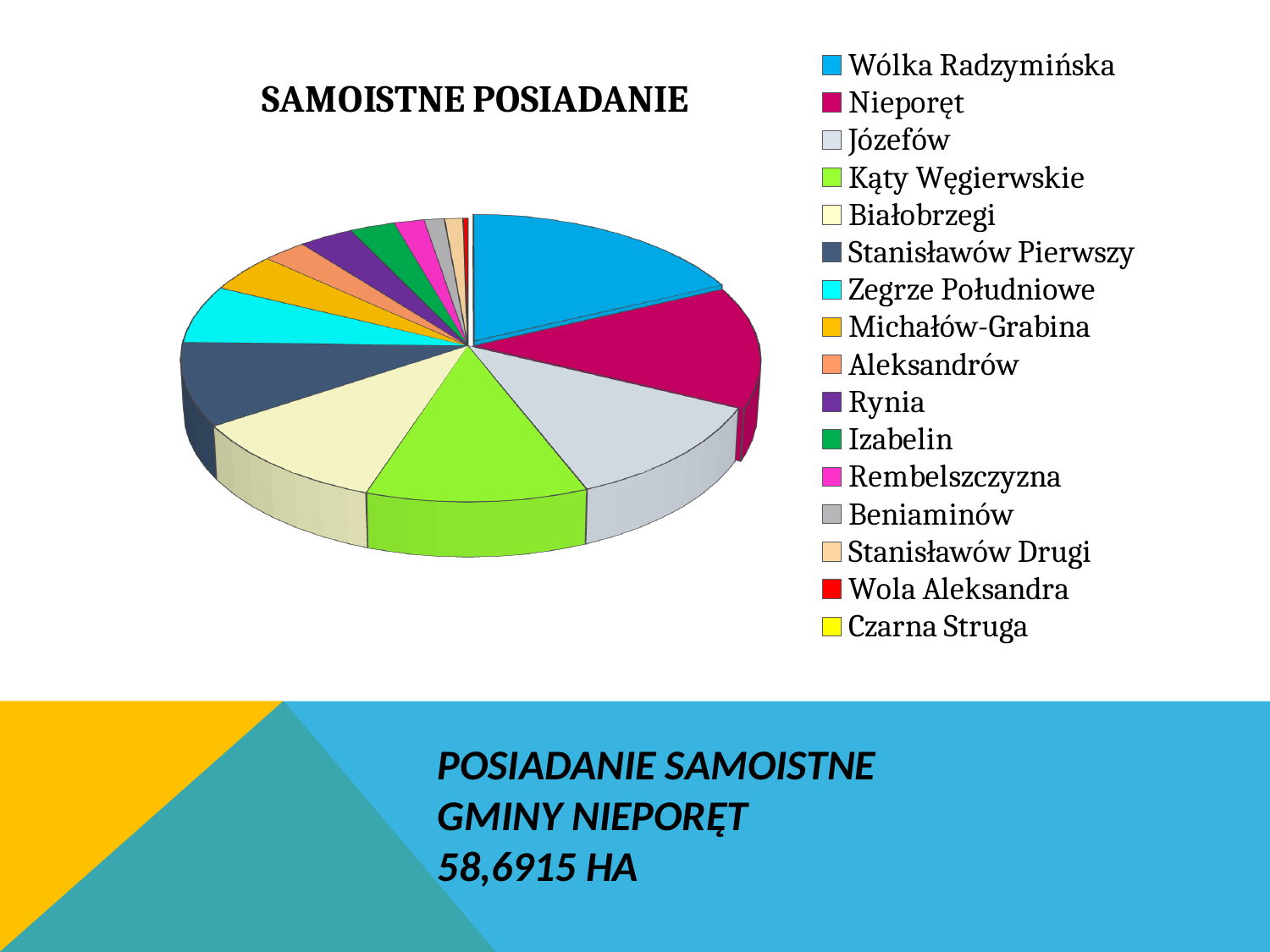
Which slice is larger, Kąty Węgierwskie or Beniaminów? Kąty Węgierwskie Which colour represents Nieporęt in the pie chart? Crimson (dark pink) Which category is listed first in the legend? Wólka Radzymińska Which category has the largest slice of the pie? Wólka Radzymińska Which slice is larger, Nieporęt or Izabelin? Nieporęt Which slice is larger, Józefów or Aleksandrów? Józefów What kind of chart is shown on the slide? Pie chart How many categories does the legend of the pie chart list? 16 Which category is listed last in the legend? Czarna Struga What is the title of the chart? SAMOISTNE POSIADANIE